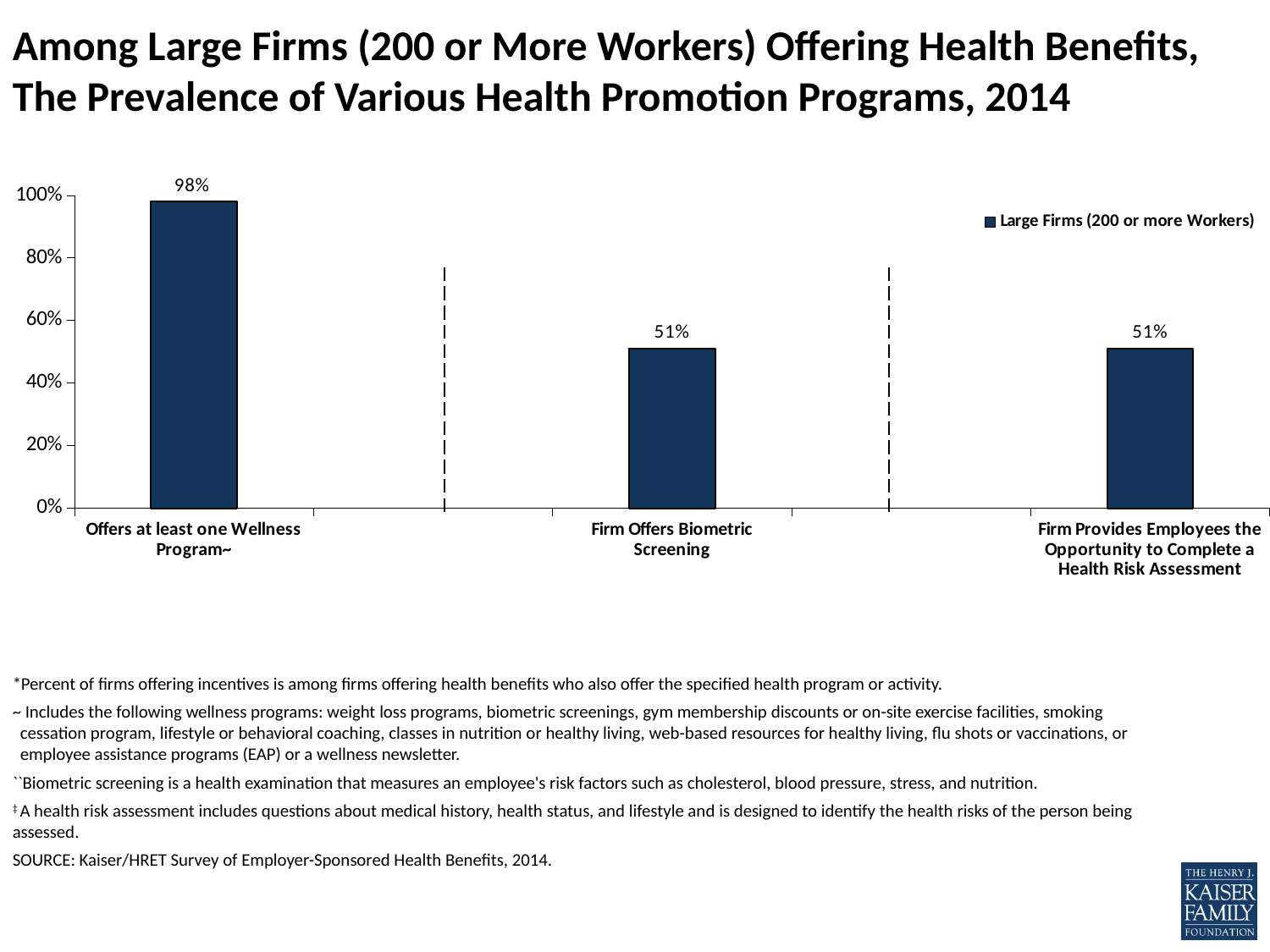
Is the value for Offers at least one Wellness Program greater or less than 80%? greater Which is larger: the value for offering at least one wellness program or the value for providing a health risk assessment? Offers at least one Wellness Program~ Which category has the highest value in the chart? Offers at least one Wellness Program~ What percentage of large firms provide employees the opportunity to complete a health risk assessment? 51% How many categories are shown in the chart? 3 Is the value for Firm Offers Biometric Screening greater or less than 60%? less What percentage of large firms offer biometric screening? 51% What percentage of large firms offer at least one wellness program? 98% What is the difference between the value for offering at least one wellness program and the value for offering biometric screening? 47 percentage points What is the series name shown in the legend? Large Firms (200 or more Workers) What kind of chart is shown on the slide? Bar chart How many series does the legend list? 1